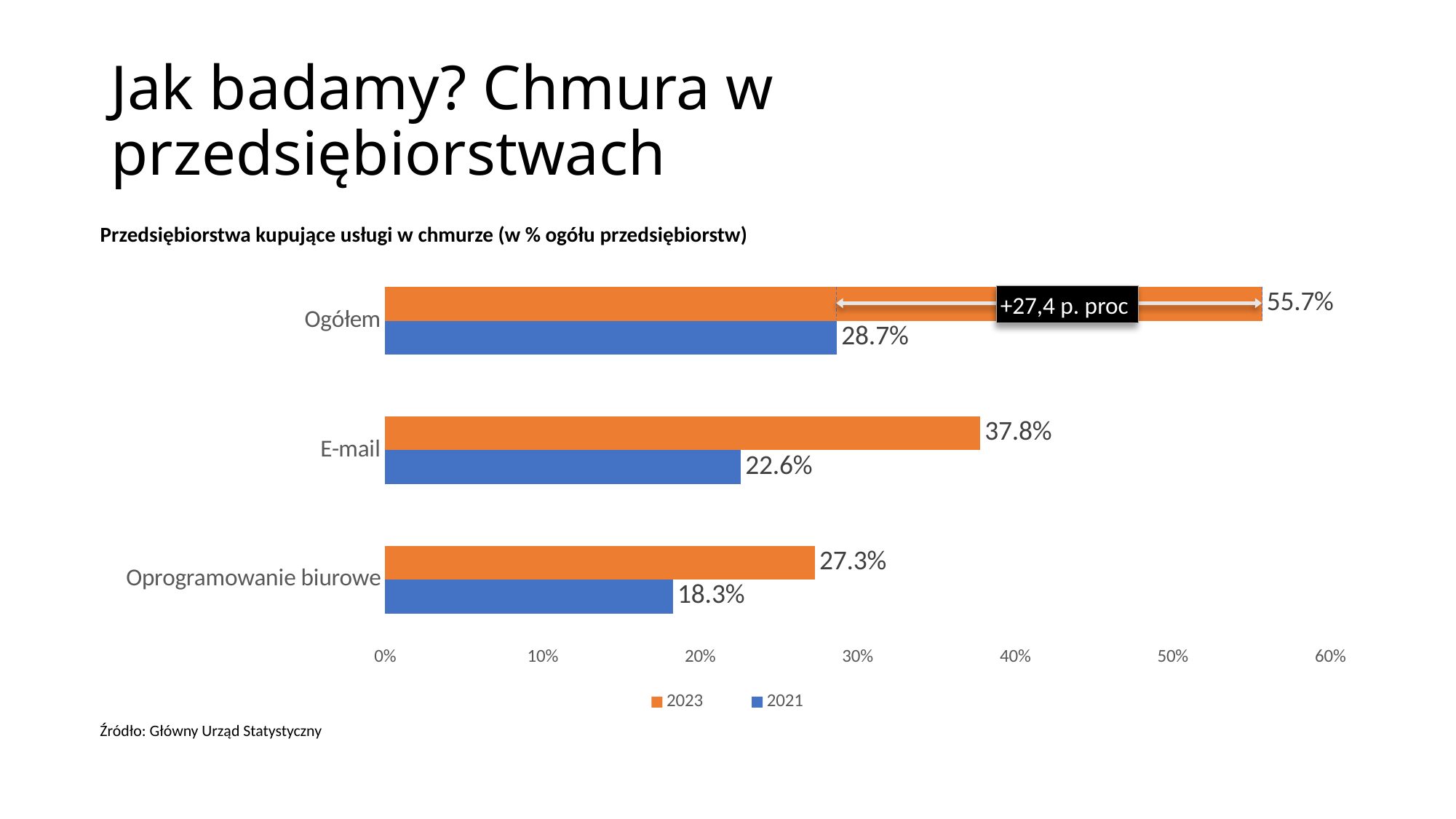
What is the 2023 value for Oprogramowanie biurowe? 27.3% What is the 2023 value for Ogółem? 55.7% How many series does the legend list? 2 What type of chart is shown on the slide? bar chart Which category has the lowest 2021 value? Oprogramowanie biurowe Which category has the highest 2023 value? Ogółem What is the 2021 value for Ogółem? 28.7% What is the 2021 value for E-mail? 22.6% Which colour represents the 2023 series? orange How many categories are shown on the chart? 3 Which is larger: the 2023 value for Oprogramowanie biurowe or the 2021 value for Ogółem? 2021 value for Ogółem What is the difference between the 2023 and 2021 values for E-mail? 15.2 percentage points